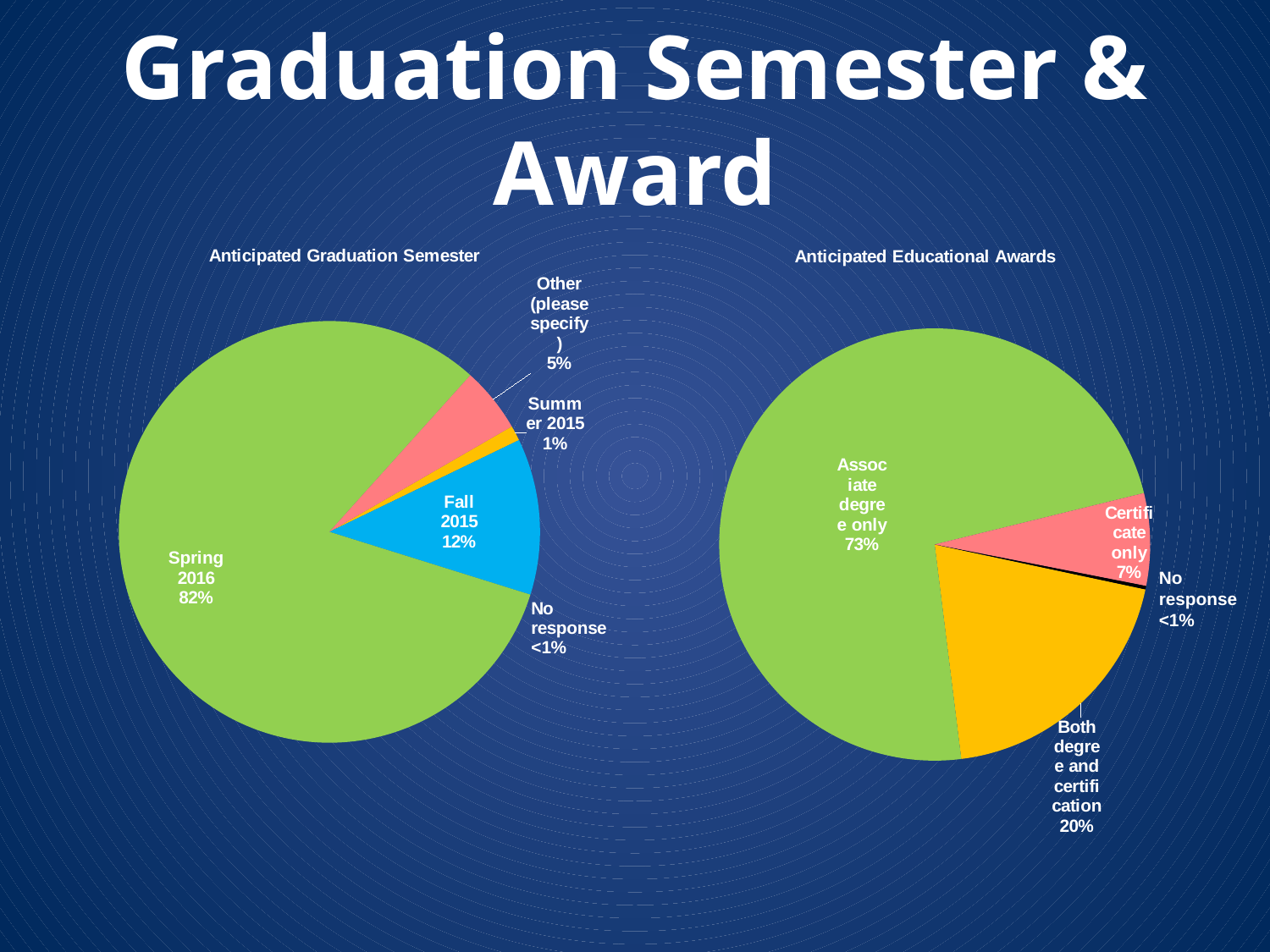
In the Anticipated Graduation Semester chart, what percentage is labelled for Fall 2015? 12% In the Anticipated Educational Awards chart, how many slices does the pie have? 4 In the Anticipated Graduation Semester chart, what percentage is shown for Other (please specify)? 5% What type of chart is used for the Anticipated Educational Awards chart? Pie chart In the Anticipated Educational Awards chart, which is larger: Both degree and certification or Certificate only? Both degree and certification In the Anticipated Graduation Semester chart, what is the difference in percentage points between Spring 2016 and Fall 2015? 70 In the Anticipated Graduation Semester chart, which category has the largest slice? Spring 2016 In the Anticipated Educational Awards chart, what percentage is shown for Both degree and certification? 20% In the Anticipated Graduation Semester chart, how many slices does the pie have? 5 In the Anticipated Educational Awards chart, what percentage is shown for Certificate only? 7% In the Anticipated Educational Awards chart, what share of the pie is Associate degree only? 73% In the Anticipated Graduation Semester chart, what share of the pie is Spring 2016? 82%